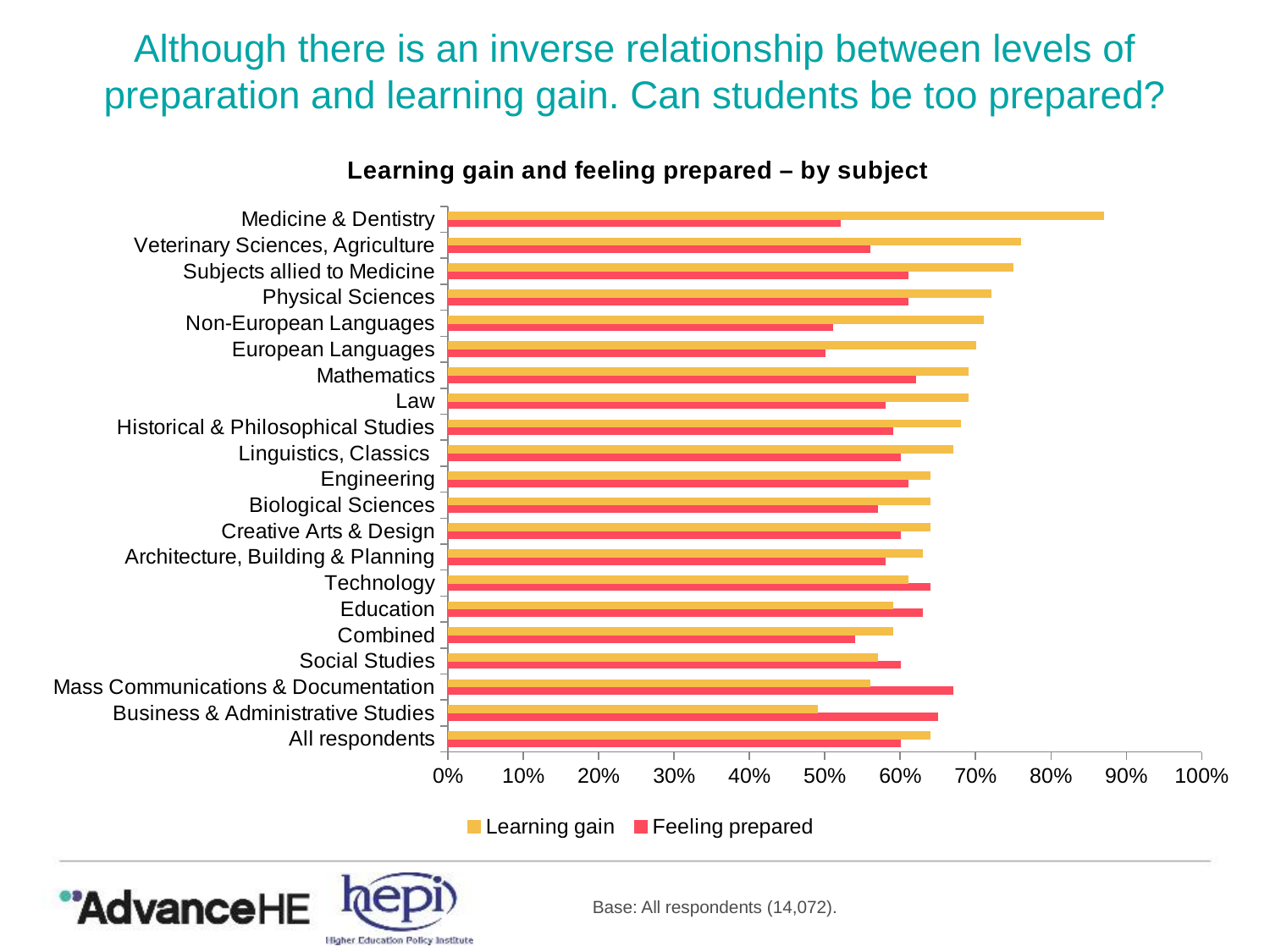
Which category has the lowest Learning gain value? Business & Administrative Studies Is the Feeling prepared value for Medicine & Dentistry greater or less than 60%? less Which category has the highest Learning gain value? Medicine & Dentistry For Medicine & Dentistry, which is larger: Learning gain or Feeling prepared? Learning gain How many subject categories (including All respondents) are plotted on the chart? 21 Is the Learning gain value for Medicine & Dentistry greater or less than 80%? greater Is the Feeling prepared value for Mass Communications & Documentation greater or less than 60%? greater For Business & Administrative Studies, which is larger: Learning gain or Feeling prepared? Feeling prepared What is the title of the chart? Learning gain and feeling prepared – by subject What kind of chart is shown on the slide? Bar chart How many series does the legend list? 2